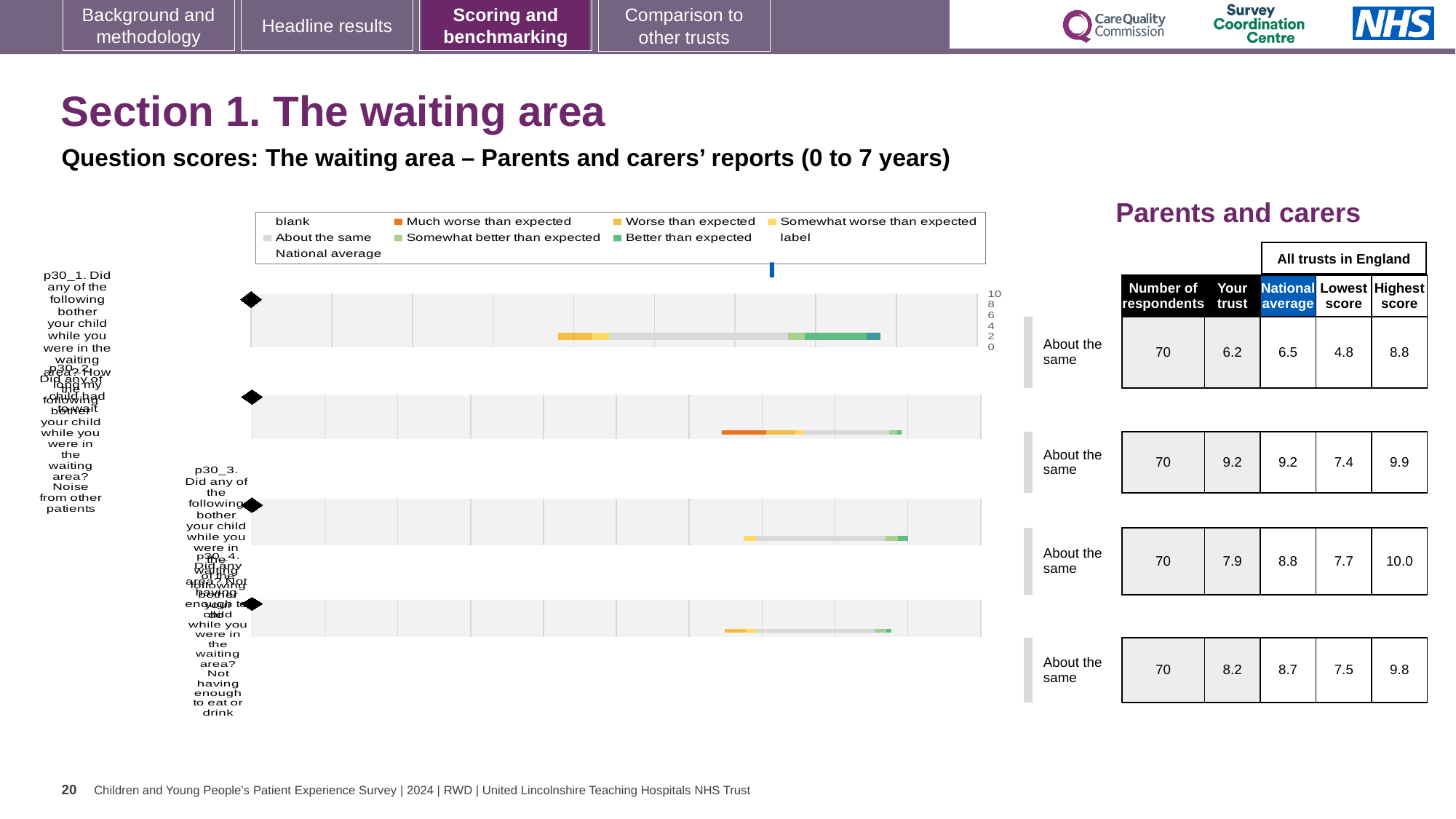
Which legend entry is shown in dark green in the chart? Better than expected What is the highest tick value shown on the chart's axis? 10 How many entries does the chart legend list? 9 How many horizontal bars are plotted in the chart? 4 Which legend entry is shown in orange in the chart? Much worse than expected What kind of chart is shown on the slide? bar chart